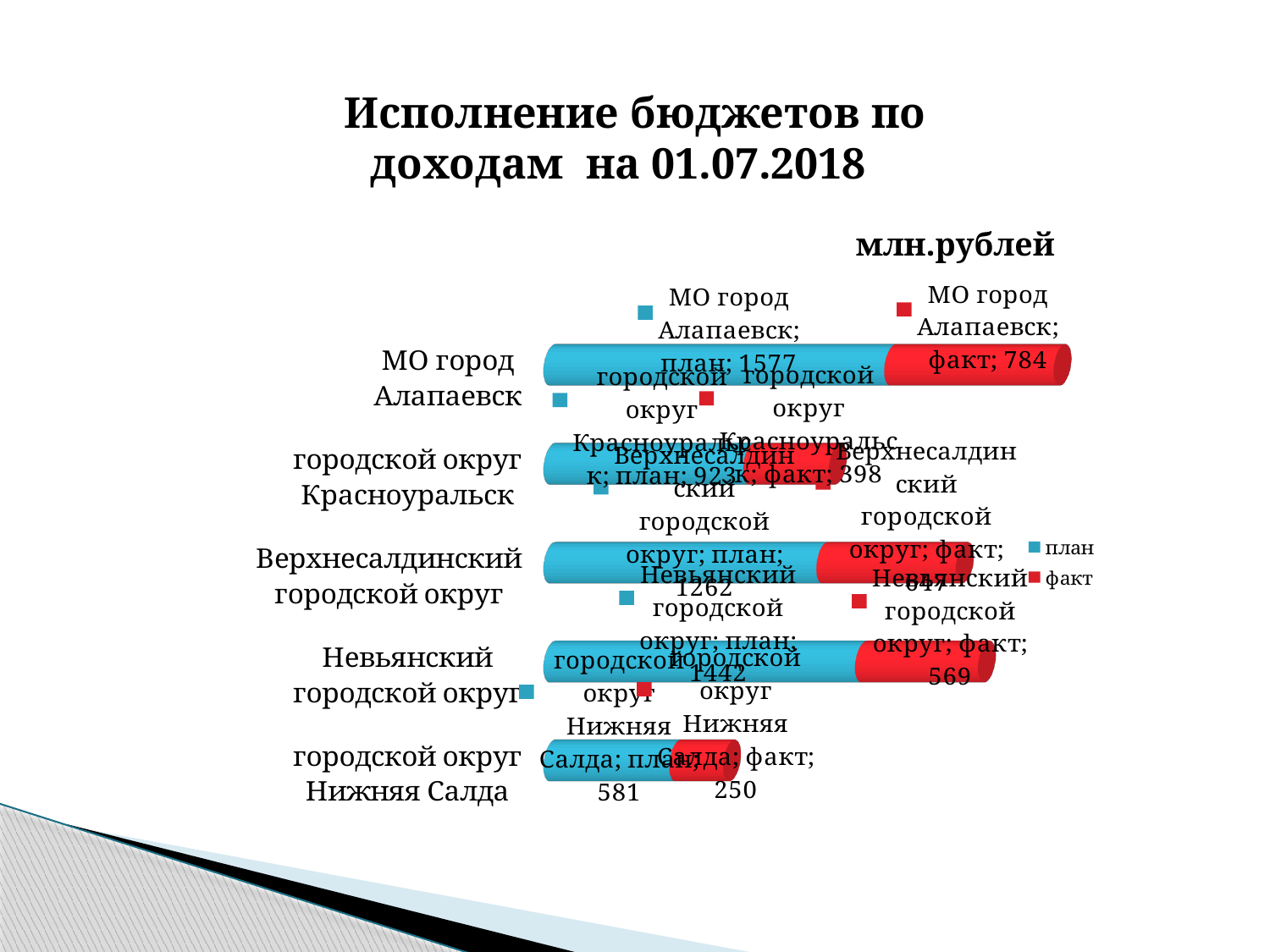
What is the план value for МО город Алапаевск? 1577 What is the difference between the план and факт values for МО город Алапаевск? 793 Which municipality has the lowest факт value? городской округ Нижняя Салда What are the two series named in the legend? план and факт What is the факт value for Невьянский городской округ? 569 What kind of chart is shown on the slide? bar chart How many series does the legend list? 2 What is the факт value for МО город Алапаевск? 784 Which municipality has the highest план value? МО город Алапаевск What is the план value for городской округ Красноуральск? 923 How many municipalities (categories) are shown in the chart? 5 What is the план value for городской округ Нижняя Салда? 581